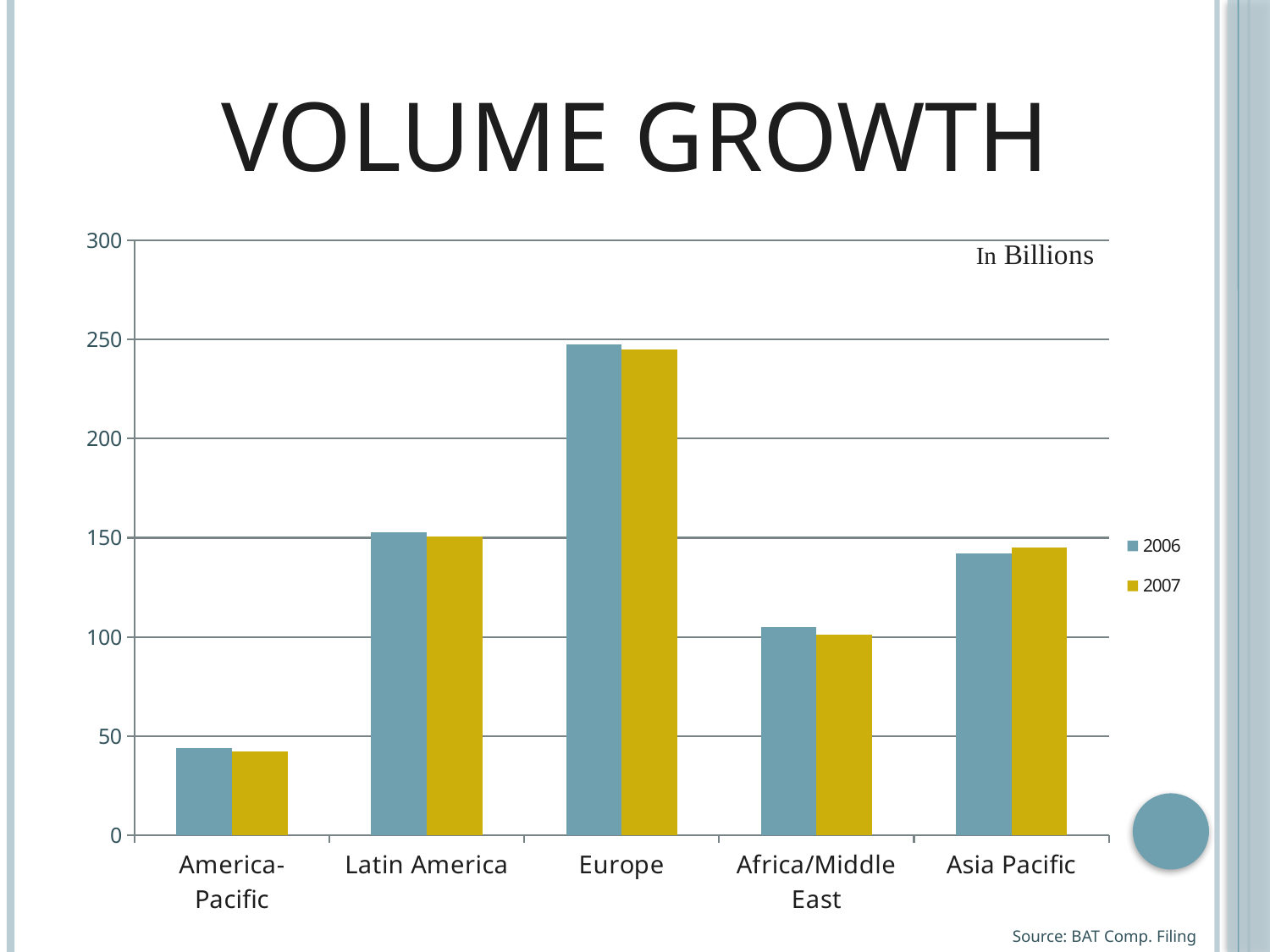
What kind of chart is shown on the slide? bar chart Is the 2007 value for Africa/Middle East greater or less than 150? less What unit is indicated in the top right of the chart area? In Billions How many series does the legend list? 2 How many regions are shown on the x axis of the chart? 5 Which region has the lowest 2007 value? America-Pacific What are the two entries in the chart legend? 2006 and 2007 Which region has the highest 2006 value? Europe Which is larger, the 2007 value for Asia Pacific or the 2007 value for Africa/Middle East? Asia Pacific Is the 2006 value for Europe greater or less than 200? greater Is the 2007 value for America-Pacific greater or less than 50? less Which is larger, the 2006 value for Europe or the 2006 value for Latin America? Europe